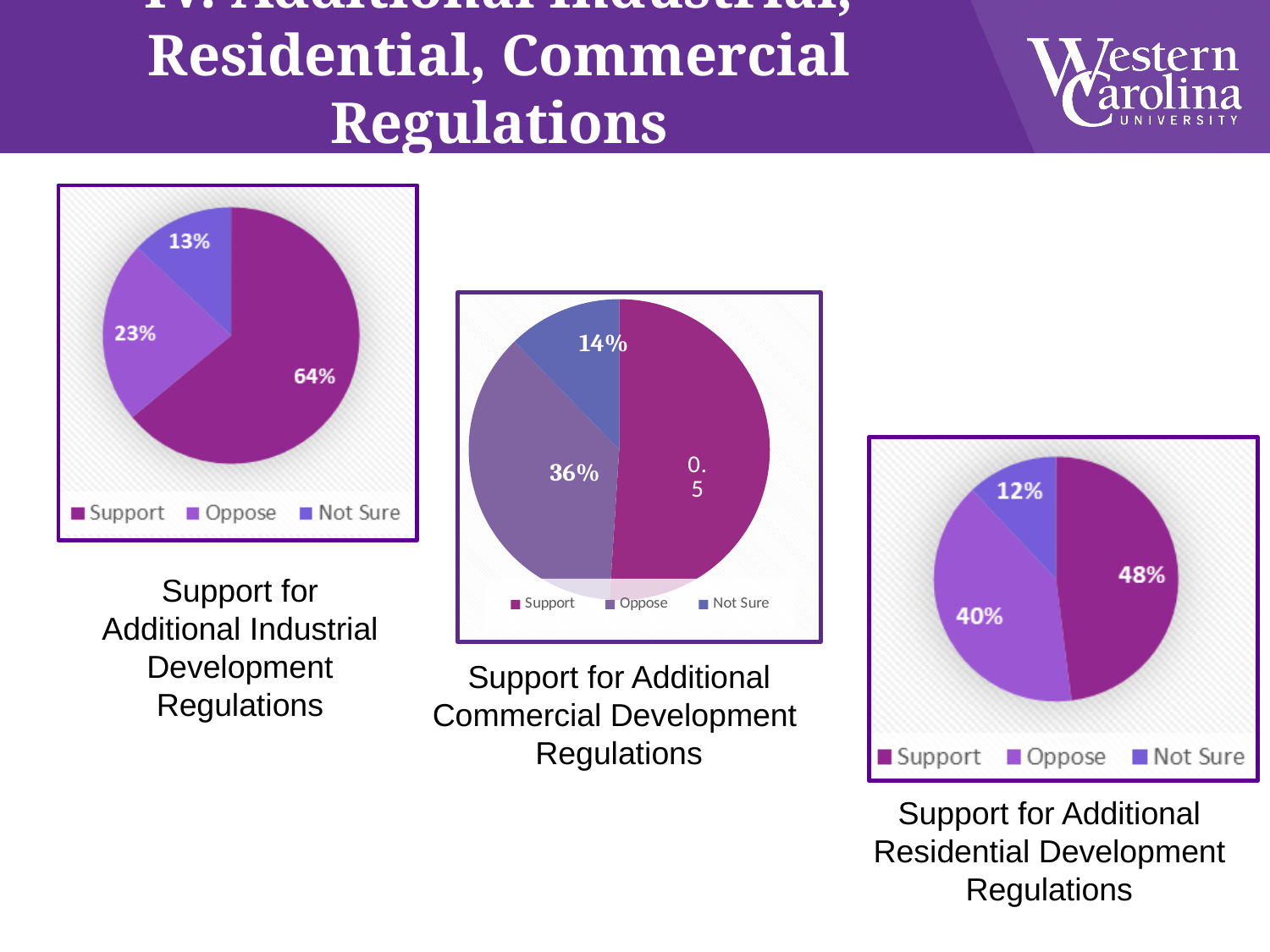
In the Support for Additional Commercial Development Regulations chart, which is larger, the Oppose slice or the Not Sure slice? Oppose In the Support for Additional Residential Development Regulations chart, what percentage is shown for Support? 48% In the Support for Additional Industrial Development Regulations chart, which category has the smallest slice? Not Sure In the Support for Additional Commercial Development Regulations chart, what percentage is shown for Oppose? 36% In the Support for Additional Residential Development Regulations chart, what percentage is shown for Not Sure? 12% In the Support for Additional Industrial Development Regulations chart, what is the difference between the Support and Oppose percentages? 41% In the Support for Additional Commercial Development Regulations chart, what percentage is shown for Not Sure? 14% In the Support for Additional Industrial Development Regulations chart, what percentage is shown for Support? 64% In the Support for Additional Industrial Development Regulations chart, what percentage is shown for Oppose? 23% What type of chart is the Support for Additional Residential Development Regulations chart? Pie chart How many categories does the legend of the Support for Additional Industrial Development Regulations chart list? 3 In the Support for Additional Residential Development Regulations chart, what is the difference between the Support and Oppose percentages? 8%